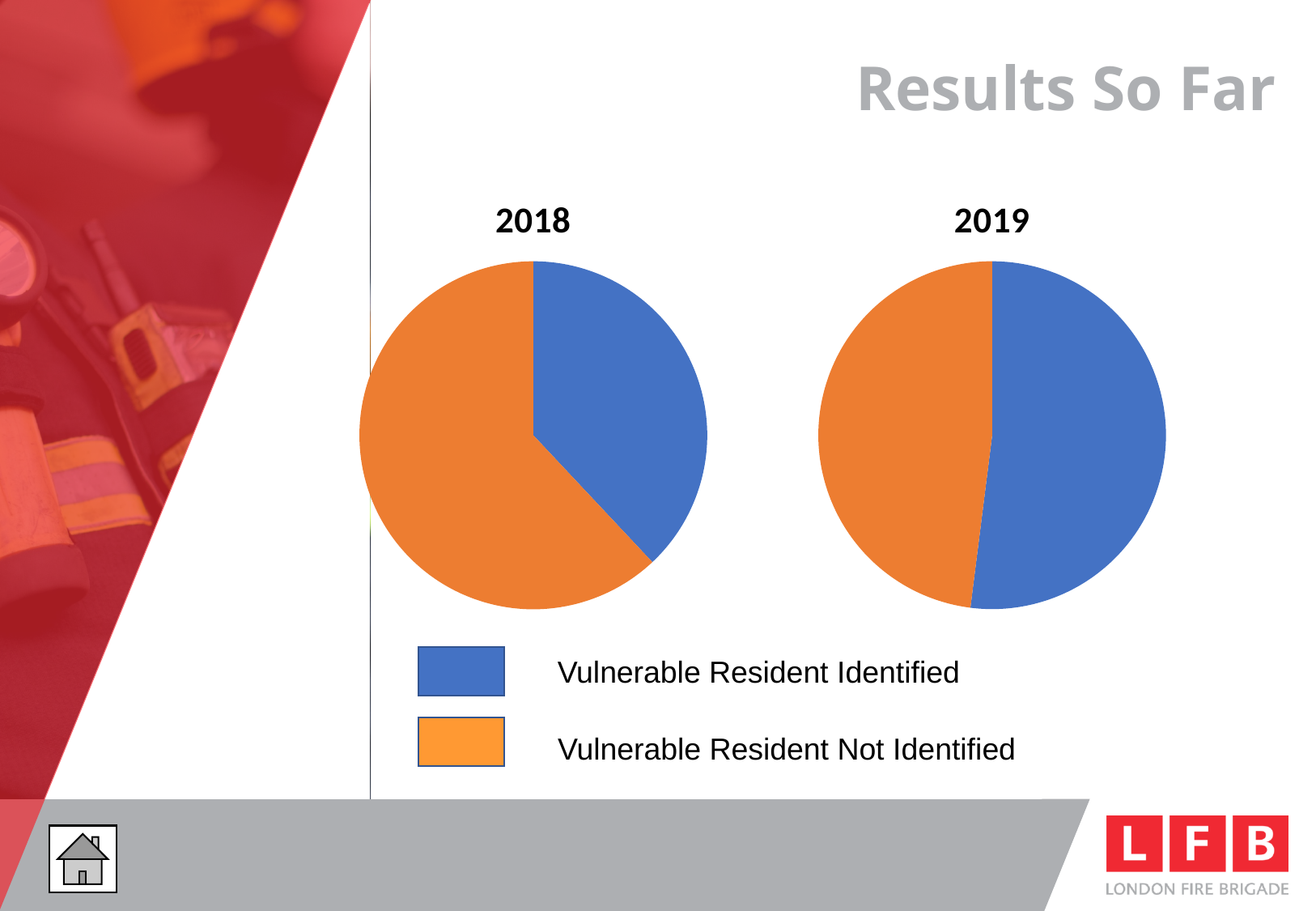
In the 2018 pie chart, which category has the smaller slice? Vulnerable Resident Identified Is the share of Vulnerable Resident Not Identified larger in the 2018 pie chart or the 2019 pie chart? 2018 In the 2018 pie chart, which category has the larger slice? Vulnerable Resident Not Identified Is the share of Vulnerable Resident Identified larger in the 2018 pie chart or the 2019 pie chart? 2019 What are the titles of the two pie charts? 2018 and 2019 How many pie charts are shown on the slide? 2 Which colour represents Vulnerable Resident Identified in the pie charts? blue How many slices does the 2019 pie chart have? 2 How many entries does the legend list? 2 What kind of chart is used for the 2018 data? pie chart